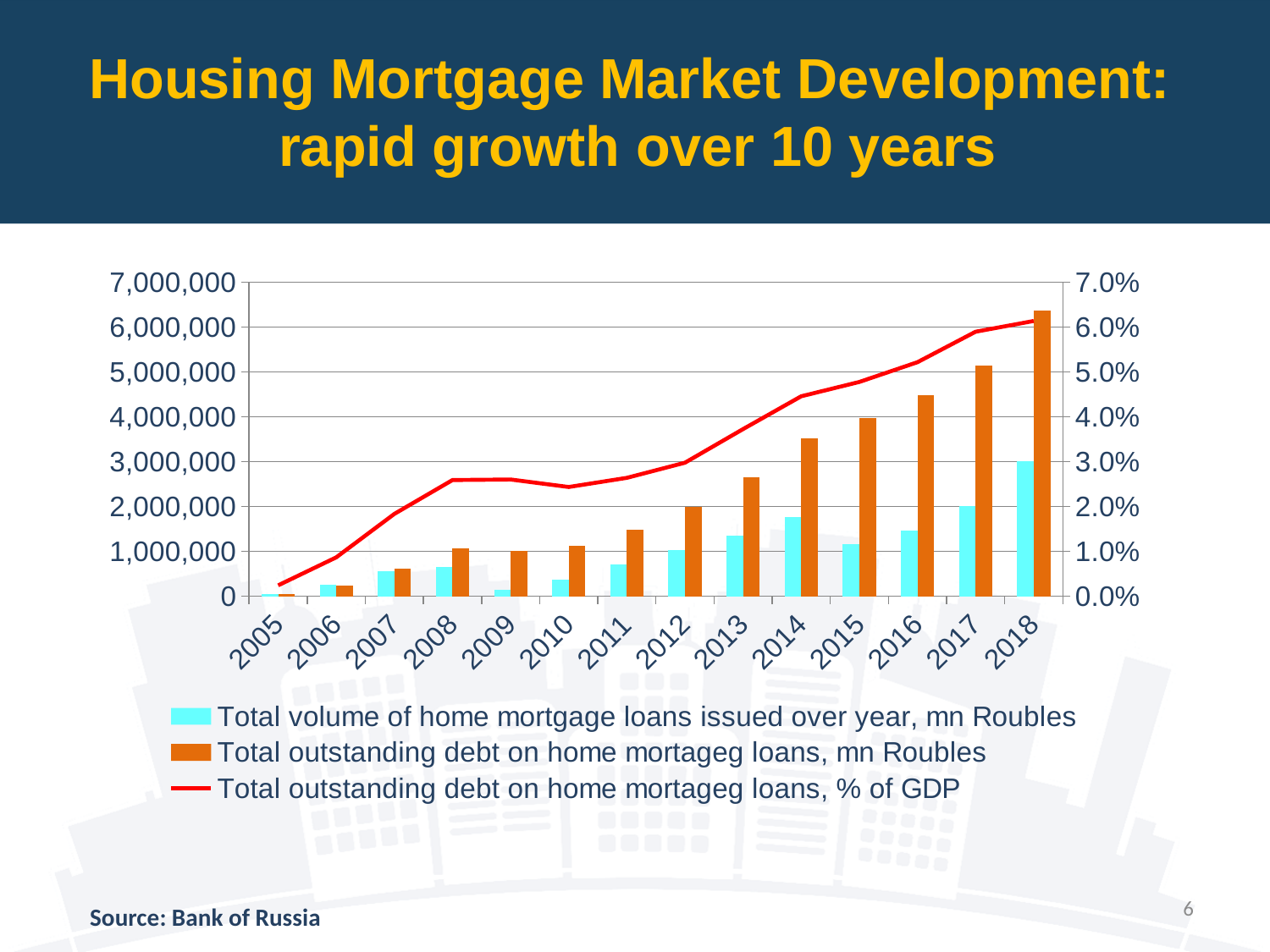
Is the total outstanding debt on home mortgage loans in 2014 greater or less than 3,000,000 mn Roubles? greater Is the total outstanding debt on home mortgage loans in 2018 greater or less than 6,000,000 mn Roubles? greater In which year is the total volume of home mortgage loans issued over the year lowest? 2005 What kind of chart is shown on the slide? A bar chart combined with a line chart What is the source cited for the chart's data? Bank of Russia Does the total outstanding debt on home mortgage loans as % of GDP generally rise or fall from 2005 to 2018? Rise How many series does the chart's legend list? 3 How many years are shown on the x axis of the chart? 14 Is the total outstanding debt on home mortgage loans as % of GDP in 2014 greater or less than 4.0%? greater In which year is the total outstanding debt on home mortgage loans (mn Roubles) highest? 2018 In 2018, which is larger: the total volume of home mortgage loans issued over the year or the total outstanding debt on home mortgage loans? Total outstanding debt on home mortgage loans